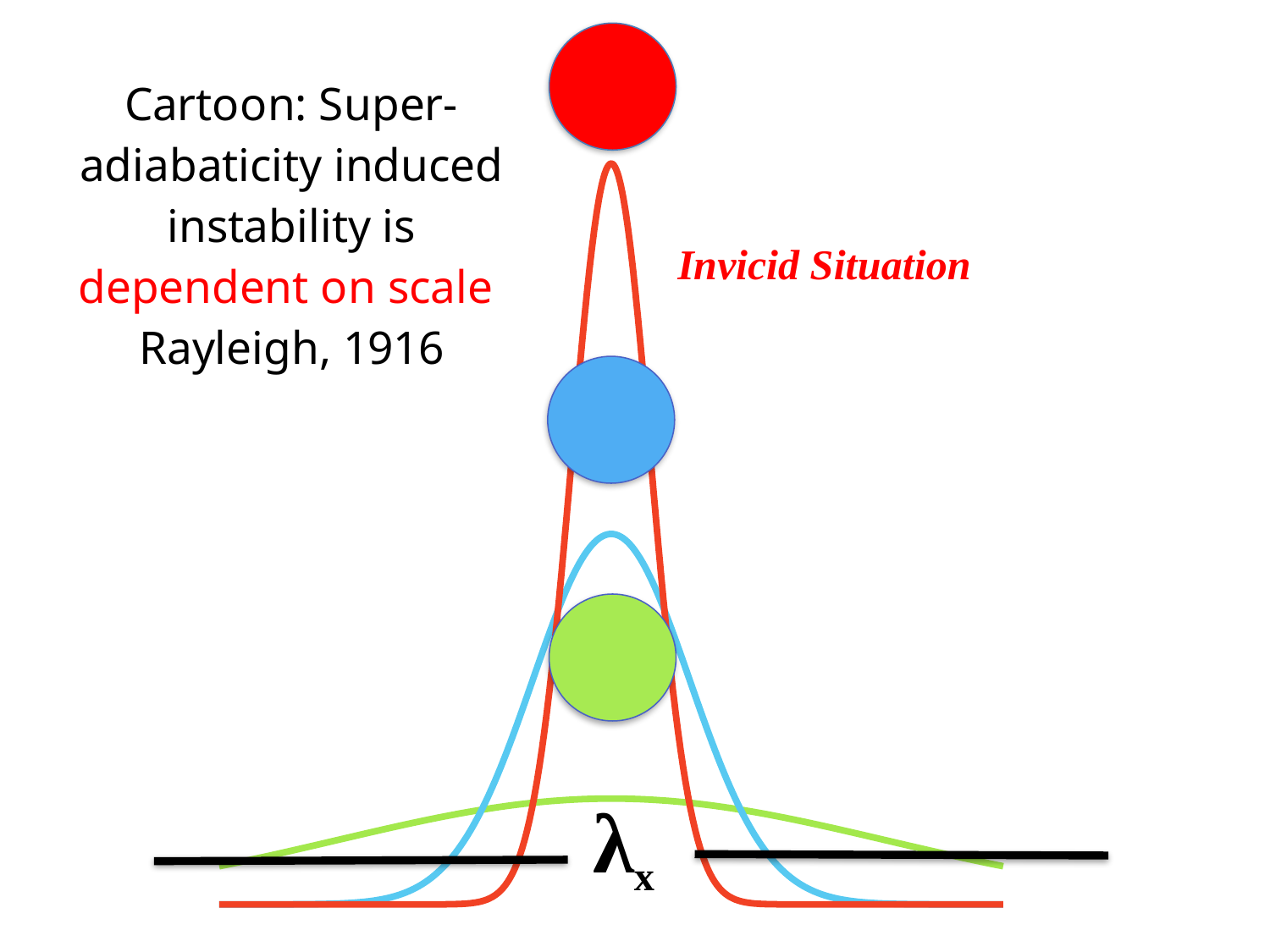
How many circles are drawn above the curves in the cartoon diagram? 3 What colour is the circle at the top of the tallest curve? red What label is written on the horizontal axis of the cartoon diagram? λx How many curves are drawn in the cartoon diagram? 3 Which coloured curve has the lowest peak in the cartoon diagram? green Which coloured curve has the highest peak in the cartoon diagram? red Is the peak of the red curve higher or lower than the peak of the blue curve? higher Which coloured curve is the widest in the cartoon diagram? green